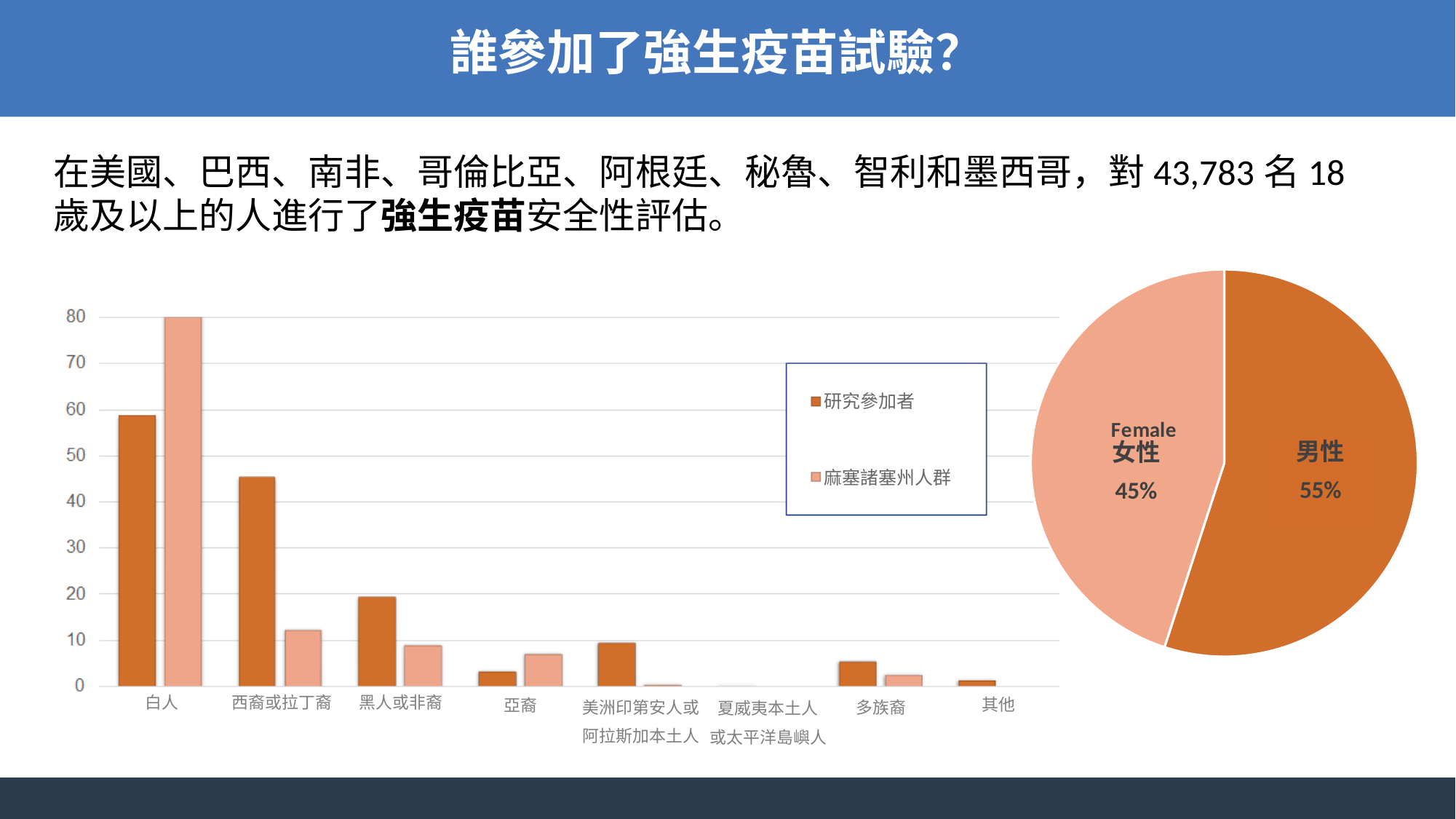
On the bar chart on the left, for 西裔或拉丁裔, which series has the larger value, 研究參加者 or 麻塞諸塞州人群? 研究參加者 On the bar chart on the left, how many categories are shown on the x axis? 8 On the pie chart on the right, how many slices are there? 2 What kind of chart is the chart on the right of the slide? Pie chart On the bar chart on the left, is the value for 白人 in the 研究參加者 series greater or less than 50? greater What kind of chart is the chart on the left of the slide? Bar chart On the pie chart on the right, what share is labelled for 女性 (Female)? 45% On the pie chart on the right, what is the difference in percentage points between the 男性 and 女性 slices? 10 percentage points On the bar chart on the left, how many series does the legend list? 2 On the pie chart on the right, which slice is larger, 男性 or 女性? 男性 On the bar chart on the left, which category has the highest value for 研究參加者? 白人 On the pie chart on the right, what share is labelled for 男性? 55%